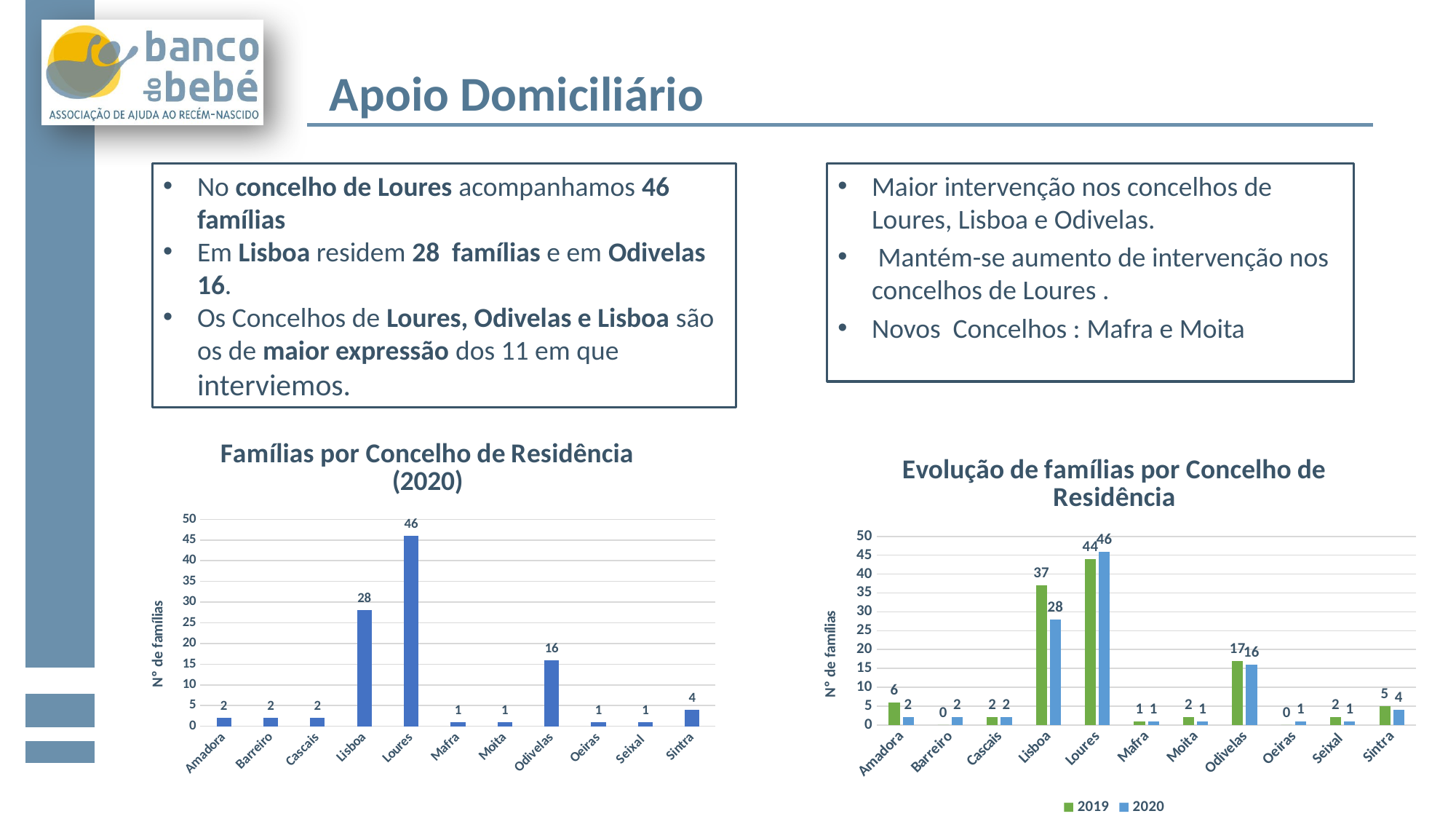
In the chart 'Evolução de famílias por Concelho de Residência', what was the value for Lisboa in 2019? 37 In the chart 'Evolução de famílias por Concelho de Residência', which is larger for Loures: the 2019 value or the 2020 value? 2020 In the chart 'Evolução de famílias por Concelho de Residência', what was the value for Barreiro in 2019? 0 In the chart 'Famílias por Concelho de Residência (2020)', how many families are in Loures? 46 In the chart 'Evolução de famílias por Concelho de Residência', how many series does the legend list? 2 In the chart 'Famílias por Concelho de Residência (2020)', what is the value for Sintra? 4 What is the y-axis label of the chart 'Famílias por Concelho de Residência (2020)'? Nº de famílias In the chart 'Famílias por Concelho de Residência (2020)', what is the difference between the values for Lisboa and Odivelas? 12 In the chart 'Famílias por Concelho de Residência (2020)', how many concelhos are shown on the x axis? 11 In the chart 'Famílias por Concelho de Residência (2020)', which concelho has the highest number of families? Loures What type of chart is 'Evolução de famílias por Concelho de Residência'? Bar chart In the chart 'Evolução de famílias por Concelho de Residência', what is the difference between the 2019 and 2020 values for Amadora? 4